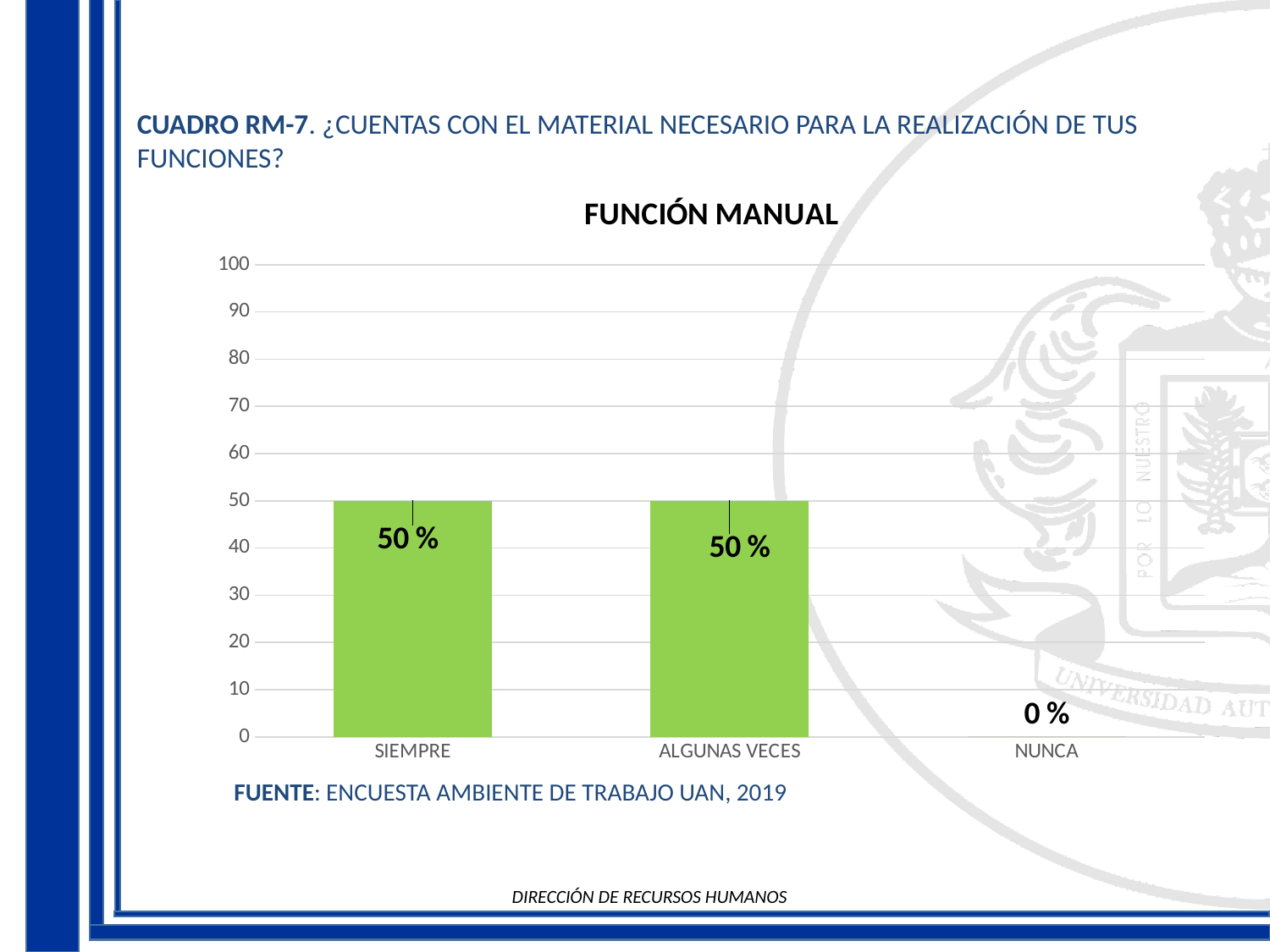
What is the total of the values for SIEMPRE and ALGUNAS VECES? 100 % Is the value for SIEMPRE greater or less than 80? less How many categories are shown on the x axis? 3 Which is larger, the value for ALGUNAS VECES or the value for NUNCA? ALGUNAS VECES What is the title of the chart? FUNCIÓN MANUAL What is the highest value shown on the y axis? 100 What is the value for NUNCA? 0 % What is the value for SIEMPRE? 50 % What is the value for ALGUNAS VECES? 50 % What kind of chart is shown? bar chart What is the difference between the values for SIEMPRE and NUNCA? 50 % Which category has the lowest value? NUNCA